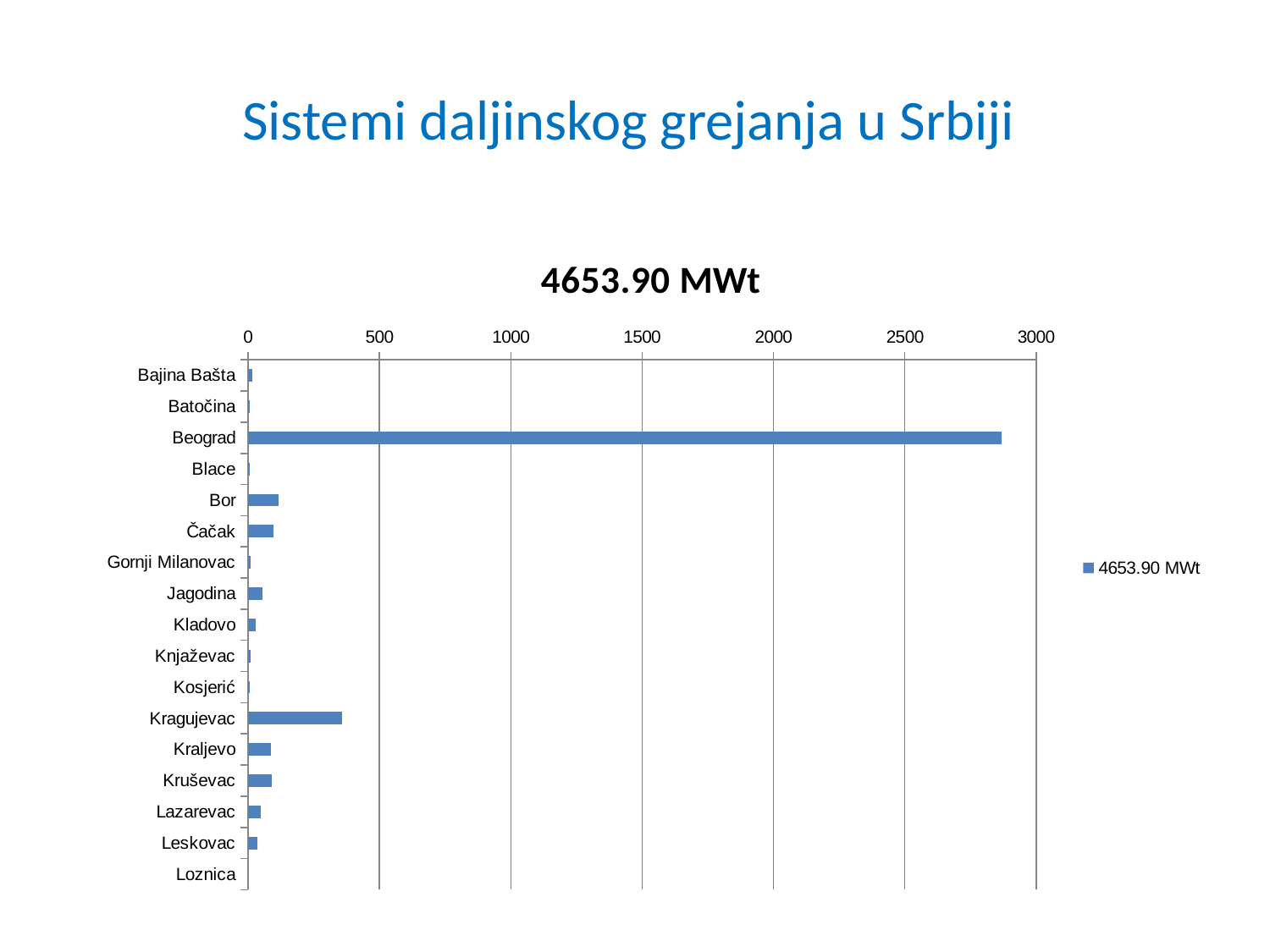
What kind of chart is shown on the slide? bar chart How many categories (cities) are listed on the chart's vertical axis? 17 What is the title of the chart? 4653.90 MWt Which is larger, the value for Kragujevac or the value for Kraljevo? Kragujevac Which is larger, the value for Kragujevac or the value for Bor? Kragujevac What is the highest value shown on the chart's horizontal axis? 3000 Is the value for Beograd greater or less than 2500? greater Which is larger, the value for Beograd or the value for Kragujevac? Beograd Is the value for Kragujevac greater or less than 500? less Which city has the highest value on the chart? Beograd How many series does the legend list? 1 Is the value for Bor greater or less than 500? less